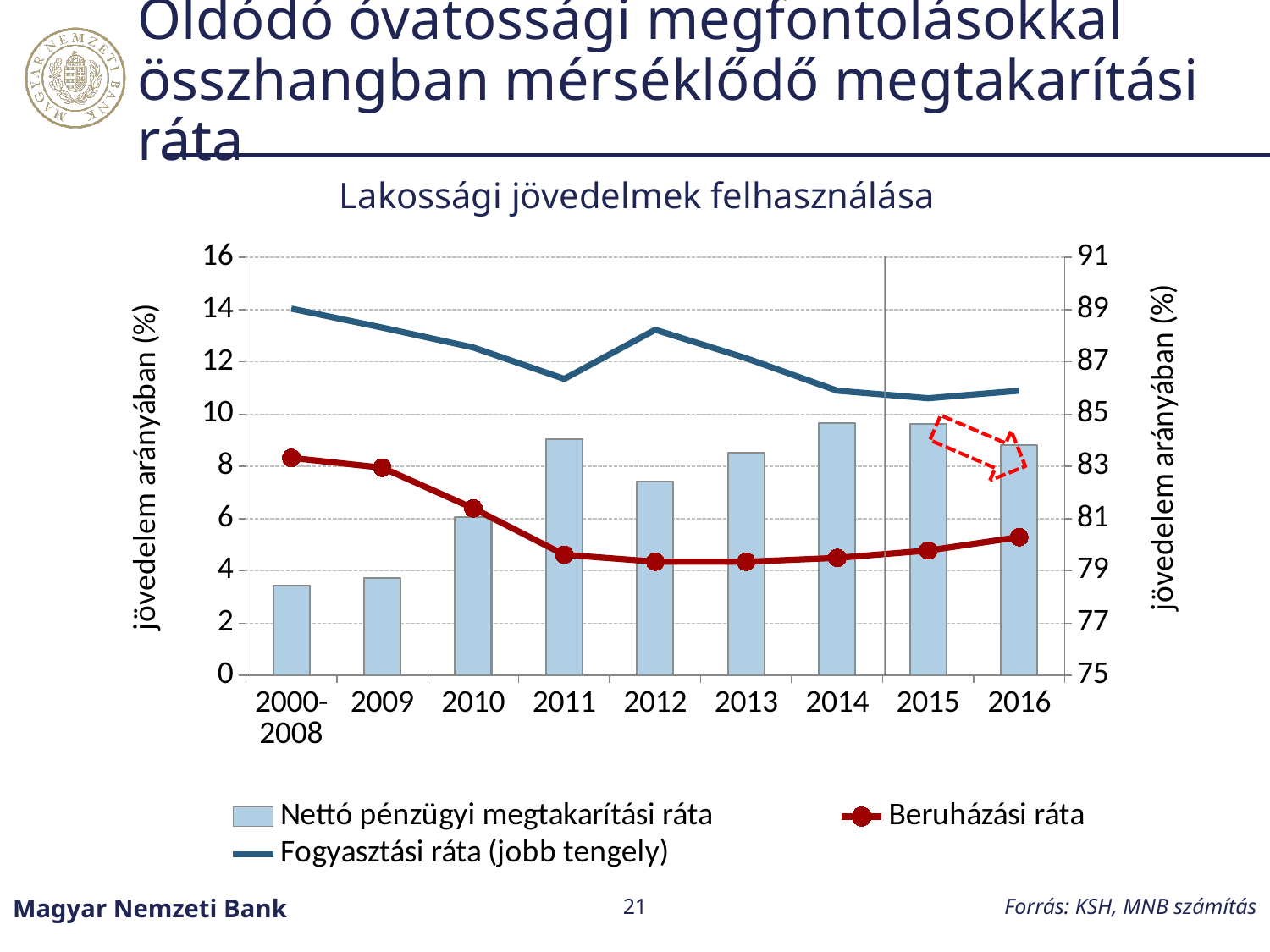
Is the Fogyasztási ráta value for 2015 greater or less than 87 on the right axis? less How many series does the chart legend list? 3 Is the Nettó pénzügyi megtakarítási ráta bar for 2000-2008 greater or less than 4? less Is the Nettó pénzügyi megtakarítási ráta bar for 2012 greater or less than 8? less In which category is the Beruházási ráta highest? 2000-2008 How many categories are shown on the x axis of the chart? 9 Does the Fogyasztási ráta line overall rise or fall from 2000-2008 to 2016? fall What is the title of the chart? Lakossági jövedelmek felhasználása Which series is plotted on the right axis (jobb tengely)? Fogyasztási ráta What kind of chart is shown on the slide? Combined bar and line chart Which is larger, the Nettó pénzügyi megtakarítási ráta bar for 2011 or for 2012? 2011